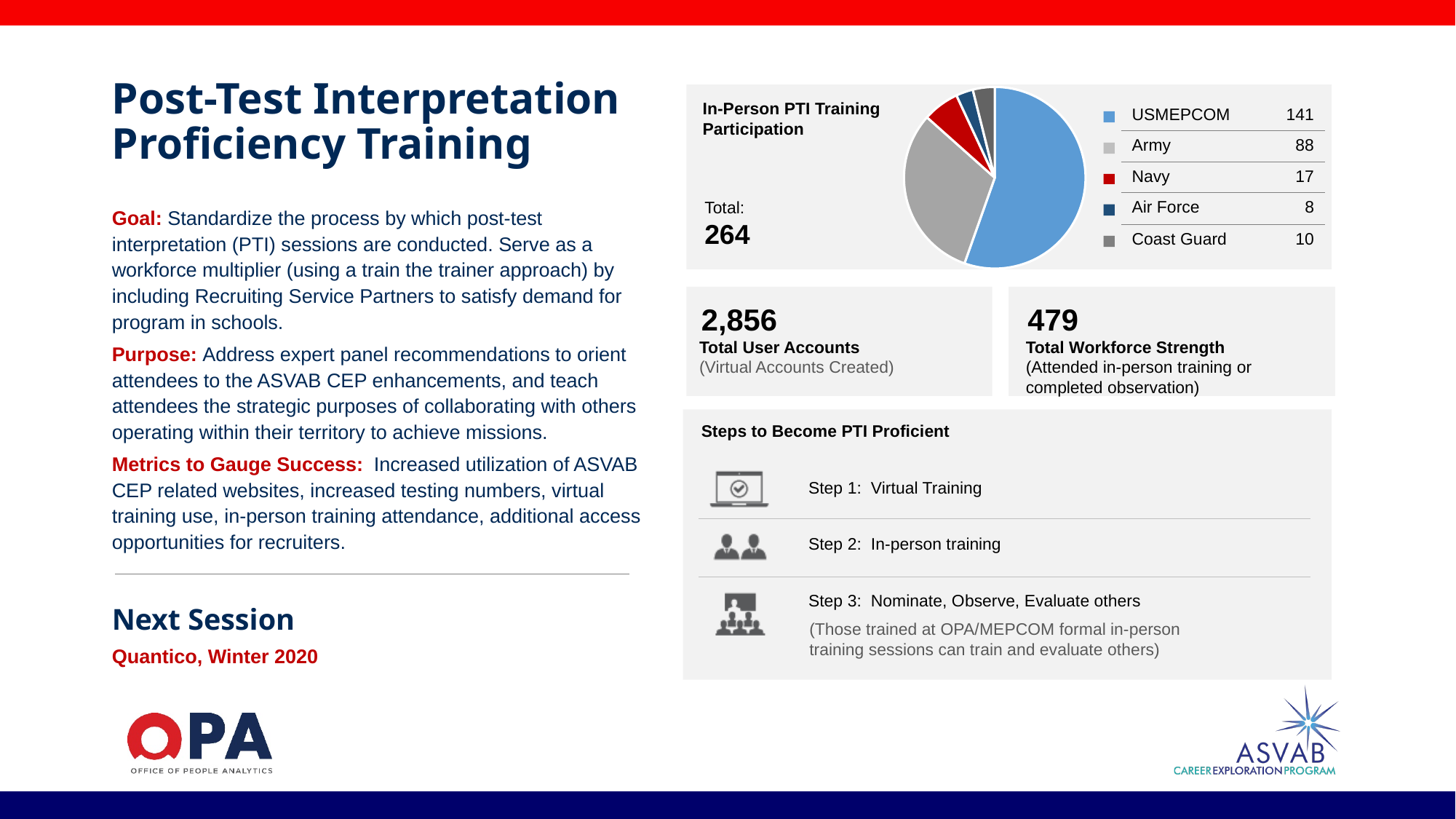
What is the value for Army in the In-Person PTI Training Participation chart? 88 Which category has the largest share of the In-Person PTI Training Participation pie? USMEPCOM What is the value for Coast Guard in the In-Person PTI Training Participation chart? 10 What kind of chart is shown under "In-Person PTI Training Participation"? pie chart What is the difference between the USMEPCOM and Army values in the In-Person PTI Training Participation chart? 53 What is the value for Navy in the In-Person PTI Training Participation chart? 17 Which is larger in the In-Person PTI Training Participation chart, Navy or Coast Guard? Navy How many categories are shown in the In-Person PTI Training Participation pie chart? 5 Which category has the smallest share of the In-Person PTI Training Participation pie? Air Force What total is shown for the In-Person PTI Training Participation chart? 264 What colour represents Navy in the In-Person PTI Training Participation pie chart? red How many in-person PTI training participants are from USMEPCOM? 141